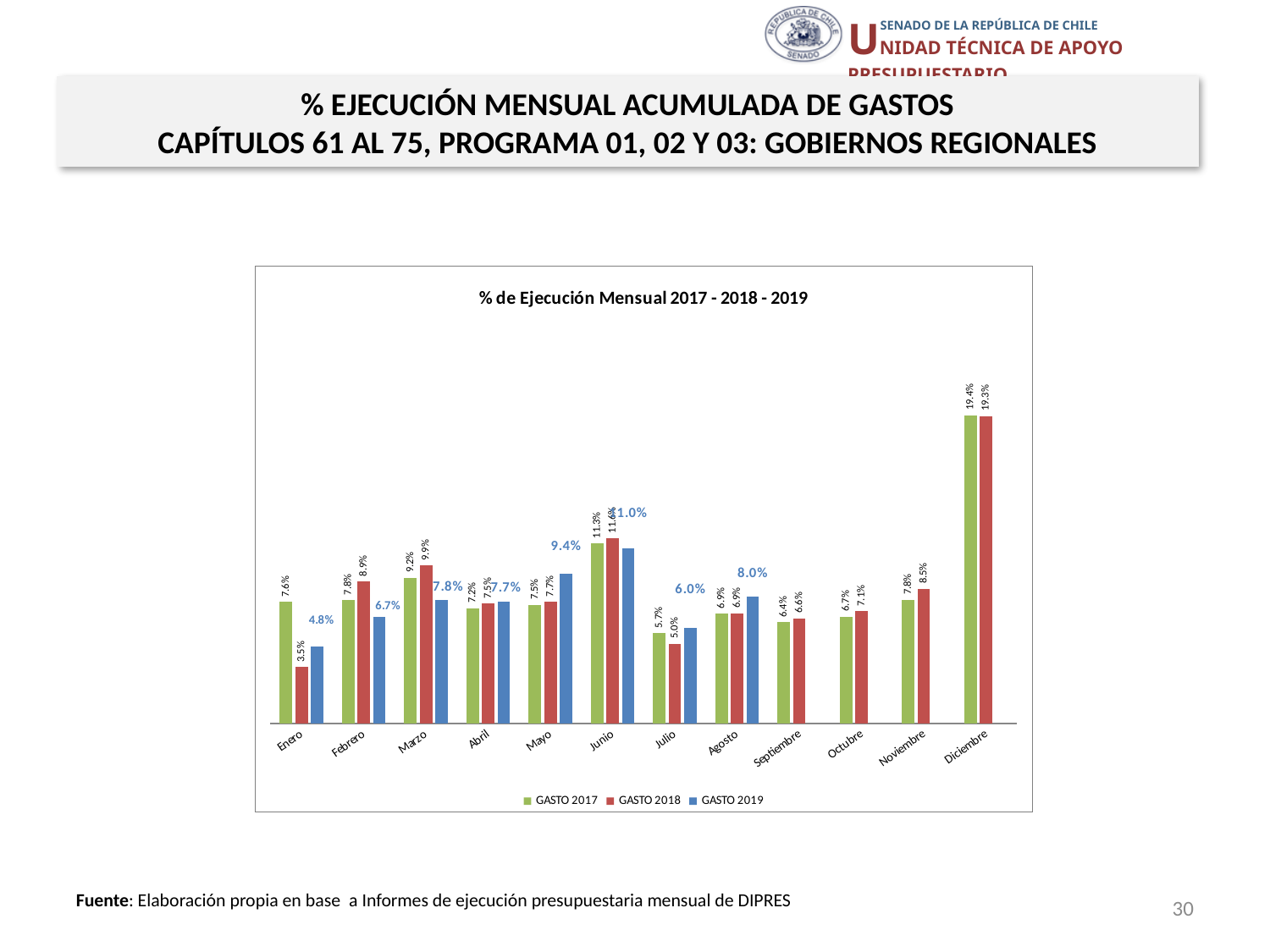
Which month has the lowest value for GASTO 2017? Julio What kind of chart is shown on the slide? Bar chart What is the value for GASTO 2018 in Enero? 3.5% What is the value for GASTO 2017 in Diciembre? 19.4% Which month has the highest value for GASTO 2018? Diciembre What is the value for GASTO 2019 in Agosto? 8.0% How many months are shown on the x axis? 12 What is the value for GASTO 2019 in Mayo? 9.4% How many series does the legend list? 3 Which is larger in Enero: GASTO 2017 or GASTO 2019? GASTO 2017 What is the title of the chart? % de Ejecución Mensual 2017 - 2018 - 2019 What is the difference between GASTO 2018 and GASTO 2017 in Febrero? 1.1%